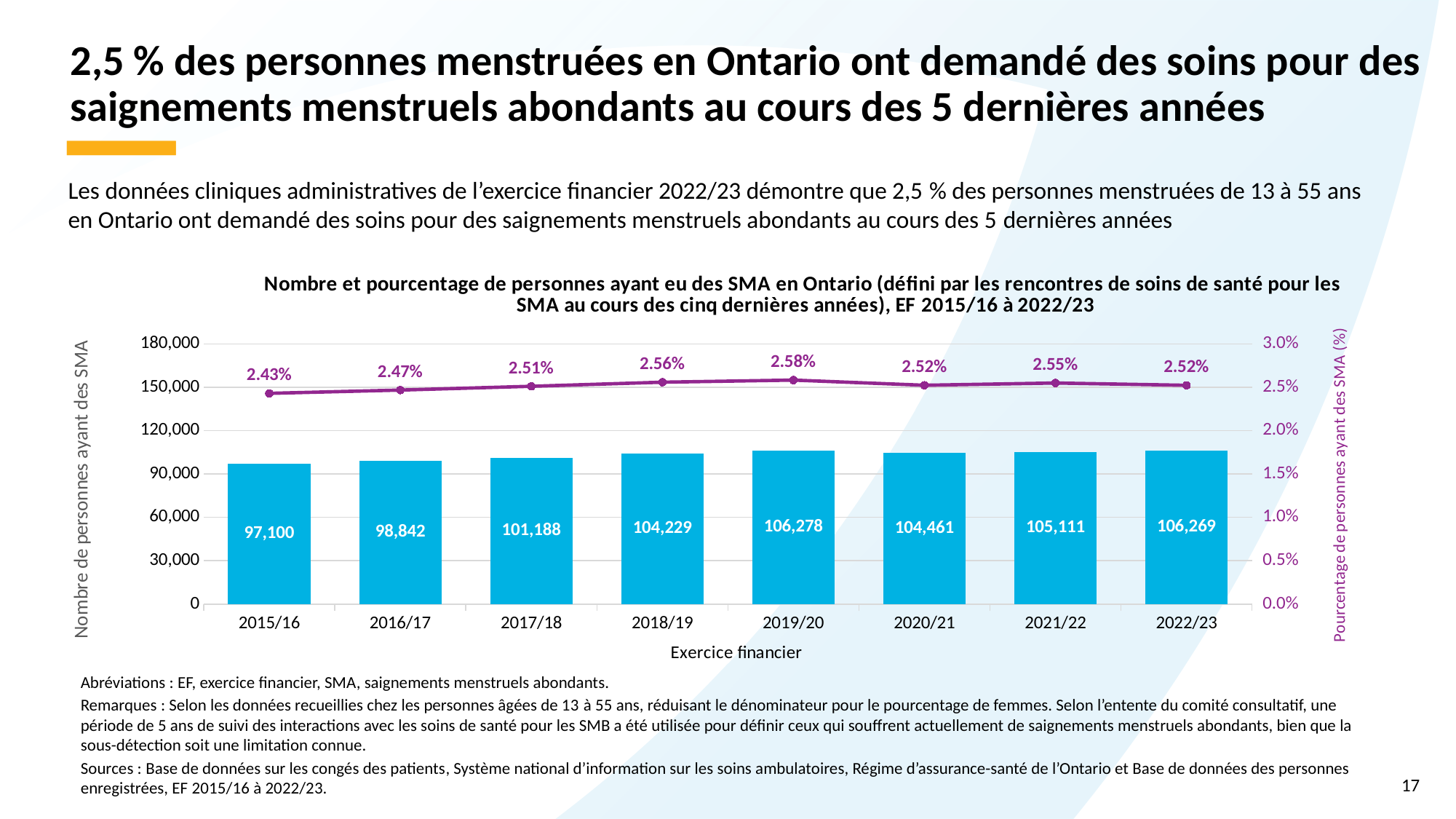
What is the number of persons with SMA in Ontario in fiscal year 2015/16? 97,100 In which fiscal year is the number of persons with SMA the lowest? 2015/16 What percentage of persons had SMA in fiscal year 2019/20? 2.58% What is the label of the left vertical axis of the chart? Nombre de personnes ayant des SMA What is the difference between the number of persons with SMA in 2022/23 and in 2015/16? 9,169 How many fiscal years are shown on the x axis of the chart? 8 Which fiscal year has a higher number of persons with SMA, 2017/18 or 2020/21? 2020/21 In which fiscal year is the percentage of persons with SMA the highest? 2019/20 Is the number of persons with SMA in 2018/19 greater or less than 90,000? greater What is the difference in percentage points between the SMA percentage in 2019/20 and in 2015/16? 0.15% Does the number of persons with SMA rise or fall from 2015/16 to 2019/20? rise What is the number of persons with SMA in fiscal year 2022/23? 106,269